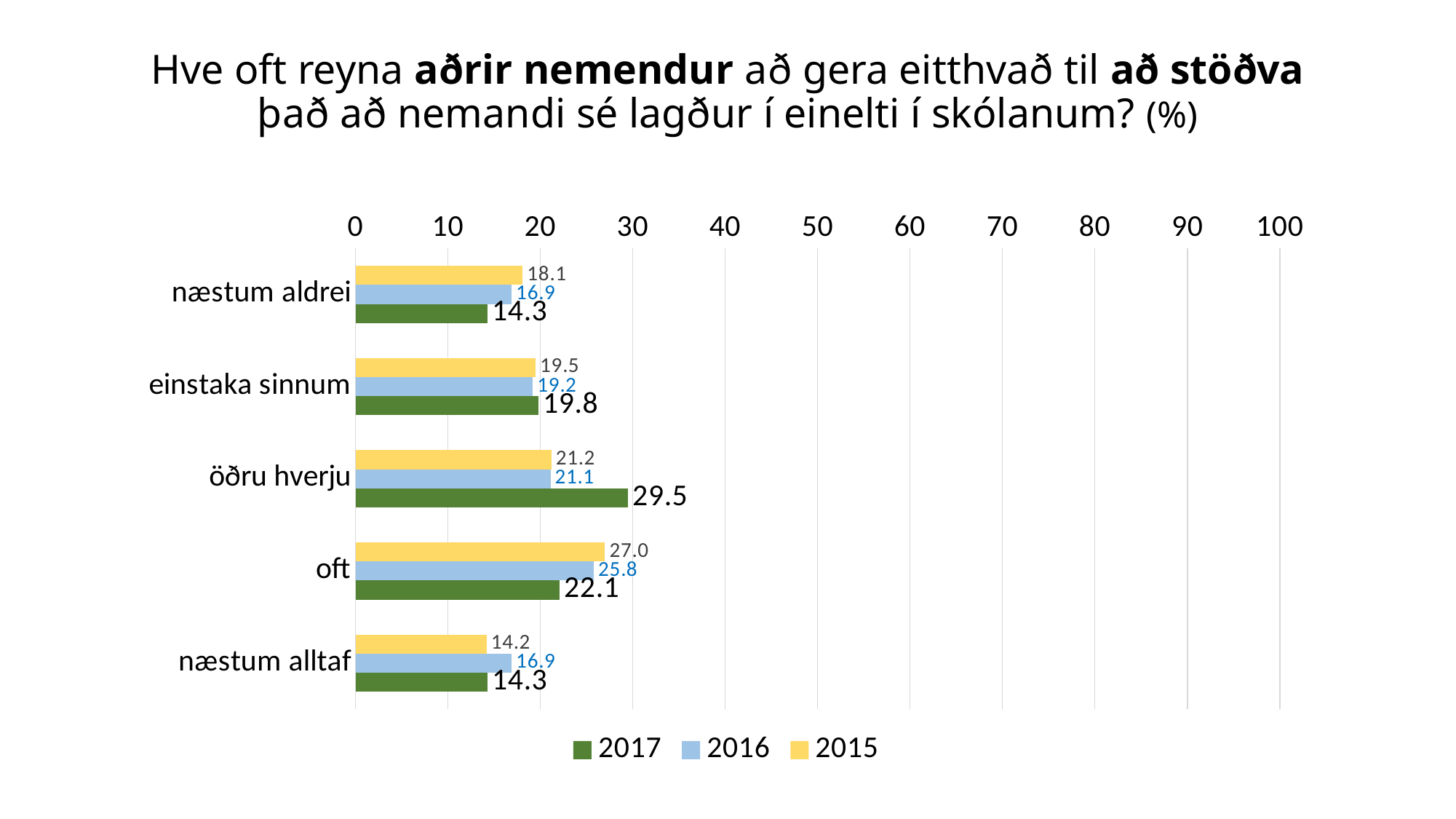
How many categories are shown on the y axis? 5 What is the difference between the 2015 and 2017 values for "oft"? 4.9 How many series does the legend list? 3 Which category has the highest 2017 value? öðru hverju Which is larger for "næstum aldrei": the 2015 value or the 2017 value? 2015 What is the 2016 value for "einstaka sinnum"? 19.2 Is the 2017 value for "öðru hverju" greater or less than 20? greater What is the 2017 value for "öðru hverju"? 29.5 Which series is shown in green in the legend? 2017 Which category has the lowest 2015 value? næstum alltaf What is the 2015 value for "oft"? 27.0 What kind of chart is shown on the slide? bar chart